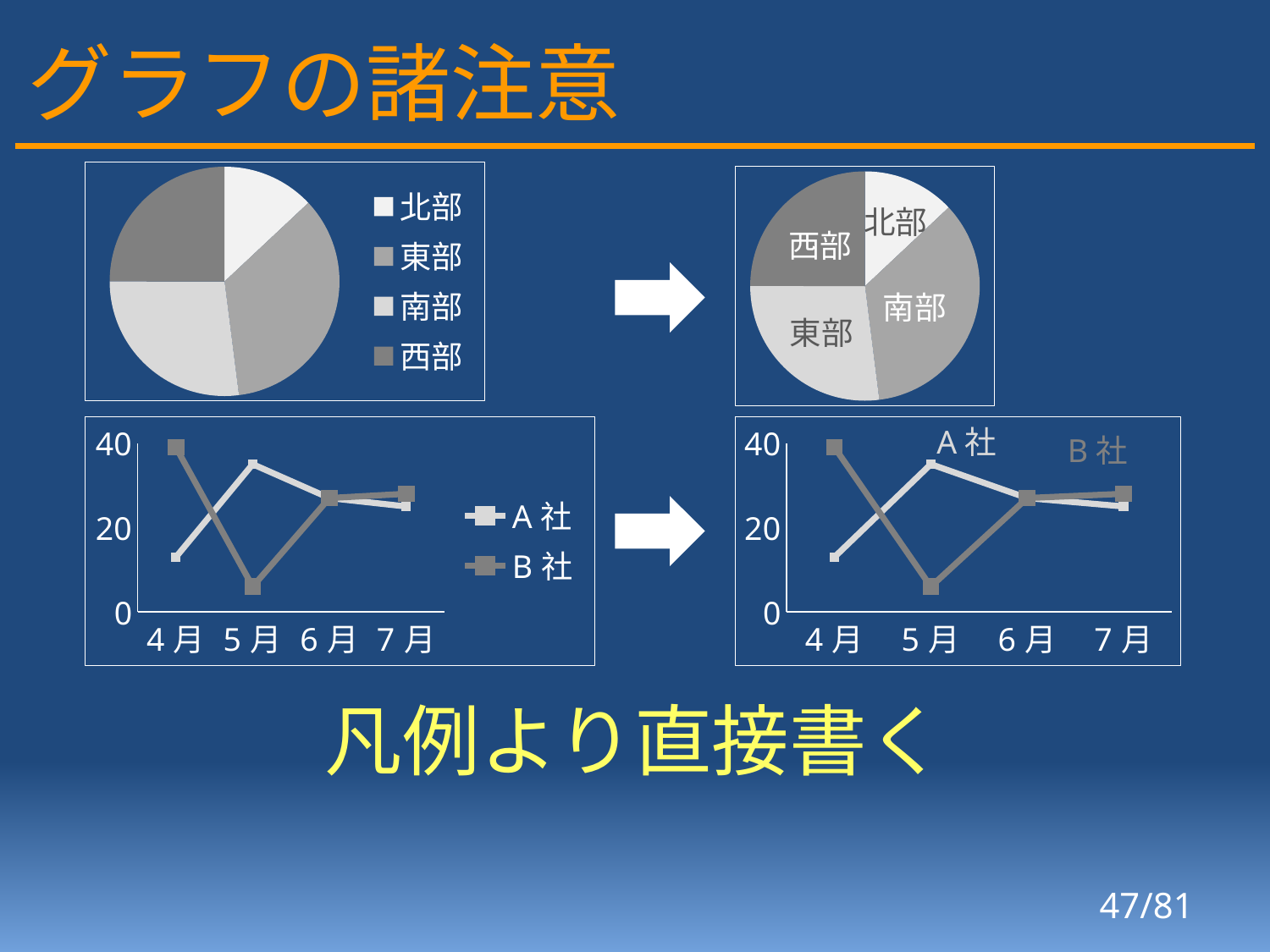
In the bottom-left line chart, is the value for B社 in 5月 greater or less than 20? less What kind of chart is the bottom-left chart on the slide? line chart What kind of chart is the top-left chart on the slide? pie chart In the bottom-left line chart, how many months are shown on the x axis? 4 In the bottom-left line chart, how many series does the legend list? 2 In the top-left pie chart, how many entries does the legend list? 4 In the bottom-right line chart, is the value for A社 in 4月 greater or less than 20? less In the bottom-left line chart, is the value for A社 in 5月 greater or less than 20? greater In the top-left pie chart, which slice is the smallest? 北部 In the bottom-right line chart, which series has the higher value in 4月, A社 or B社? B社 In the top-right pie chart, which slice is labelled directly at the top of the pie? 北部 In the bottom-right line chart, does the value for B社 rise or fall from 4月 to 5月? fall